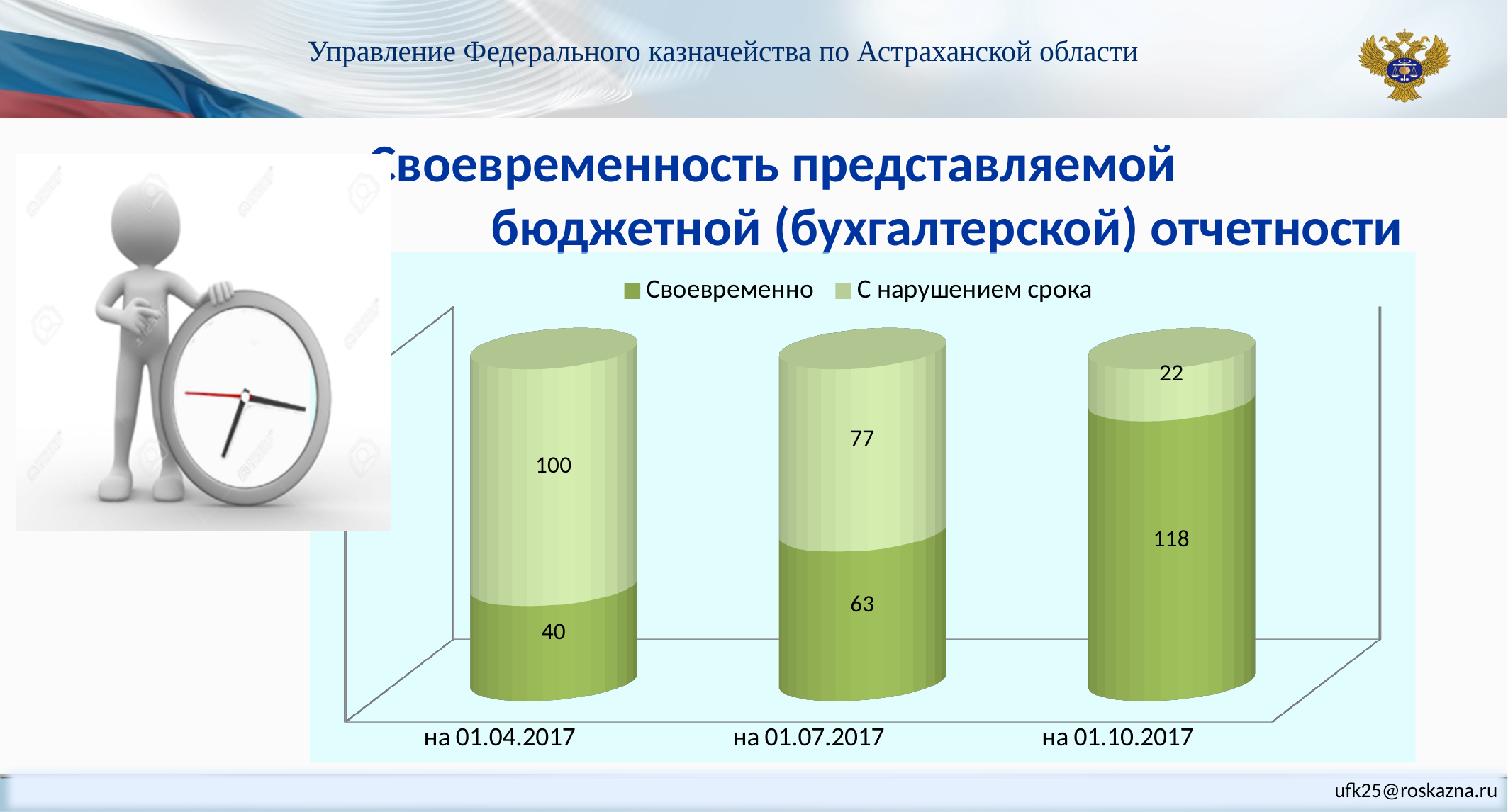
At which date is the value for "С нарушением срока" lowest? на 01.10.2017 What is the value for "С нарушением срока" at "на 01.07.2017"? 77 How many dates (categories) are shown on the x axis? 3 What is the value for "Своевременно" at "на 01.10.2017"? 118 At which date is the value for "Своевременно" highest? на 01.10.2017 Does the value for "Своевременно" rise or fall from "на 01.04.2017" to "на 01.10.2017"? rise What is the total of the stacked bar for "на 01.04.2017"? 140 Which is larger at "на 01.07.2017": "Своевременно" or "С нарушением срока"? С нарушением срока What is the value for "Своевременно" at "на 01.04.2017"? 40 How many series does the legend list? 2 What is the difference between the "Своевременно" values at "на 01.10.2017" and "на 01.04.2017"? 78 What is the value for "С нарушением срока" at "на 01.10.2017"? 22